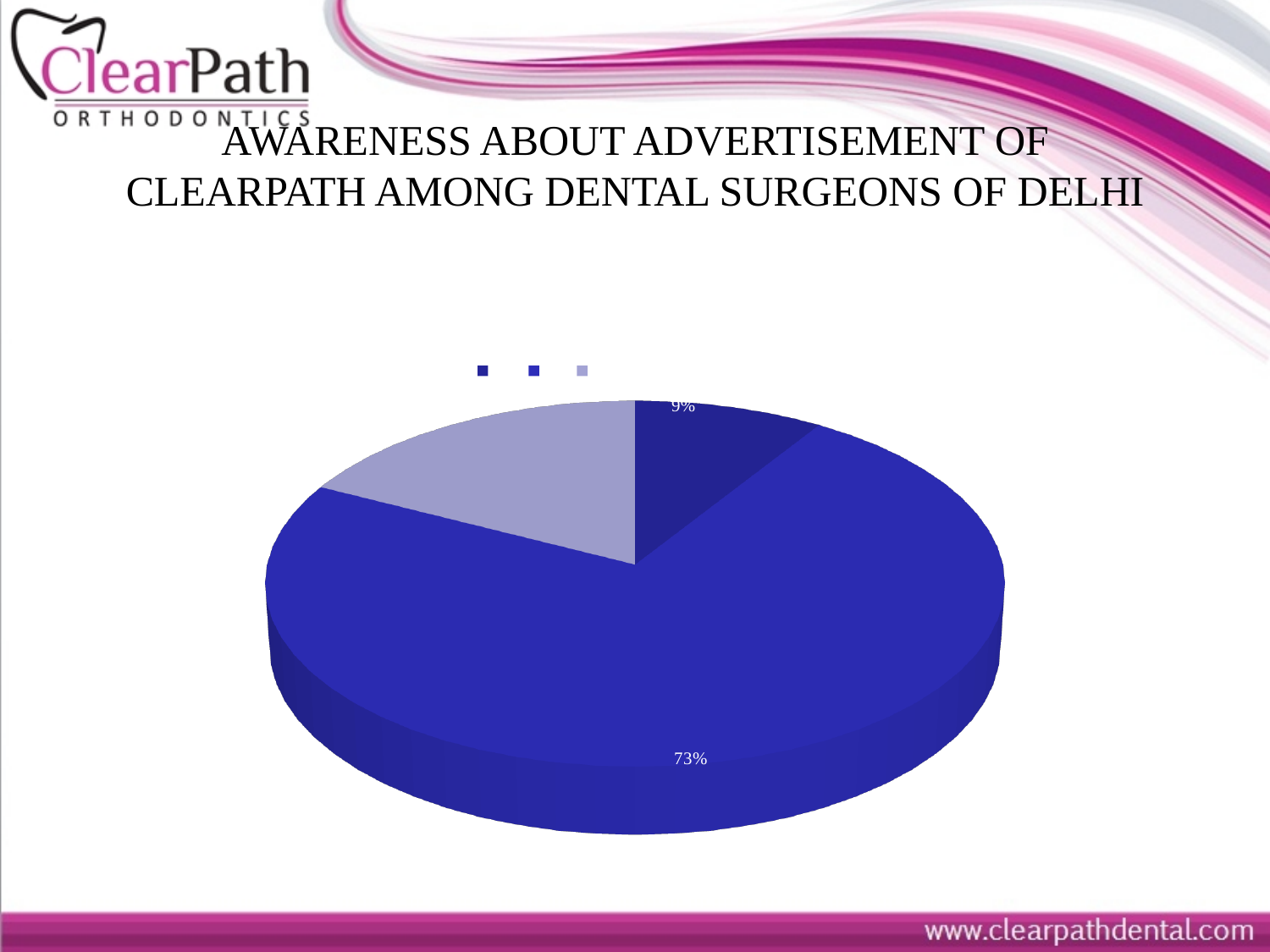
What kind of chart is shown on the slide? pie chart What is the data label on the dark blue slice of the pie chart? 9% What is the title of the chart on the slide? AWARENESS ABOUT ADVERTISEMENT OF CLEARPATH AMONG DENTAL SURGEONS OF DELHI How many entries does the legend of the pie chart list? 3 What percentage is shown for the smallest slice of the pie chart? 9% What is the difference between the 73% slice and the 9% slice of the pie chart? 64% Which slice is larger in the pie chart, the dark blue slice or the light purple slice? the light purple slice How many slices does the pie chart have? 3 What percentage is shown for the largest slice of the pie chart? 73% Which slice is larger in the pie chart, the medium blue slice or the light purple slice? the medium blue slice What colour is the largest slice of the pie chart? medium blue What is the data label on the medium blue slice of the pie chart? 73%